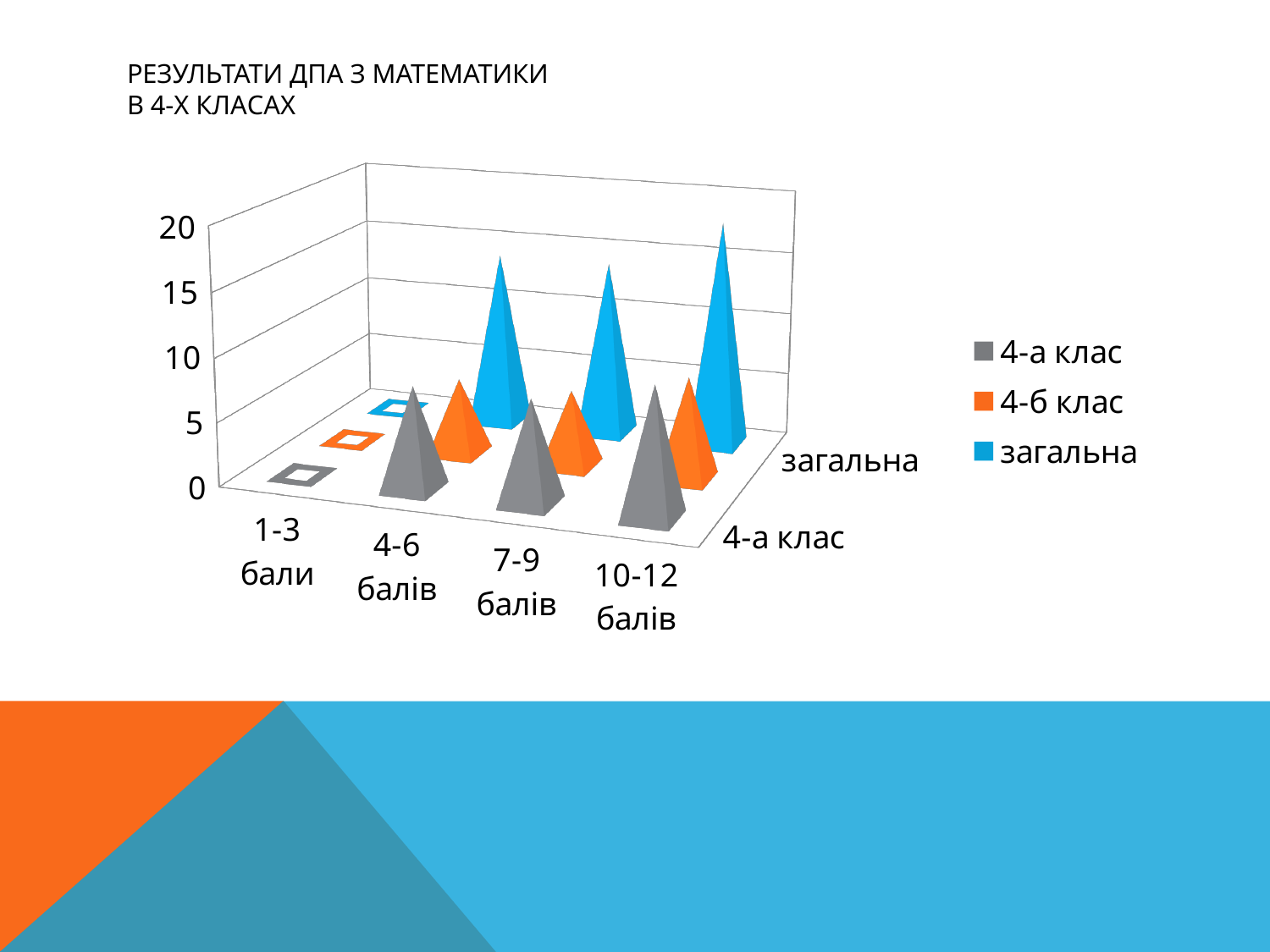
For the series 'загальна', which score category has the highest value? 10-12 балів How many score categories are shown on the x axis? 4 Is the value for '4-б клас' in the category '1-3 бали' greater or less than 5? less For the category '4-6 балів', which is larger: the value for '4-б клас' or for 'загальна'? загальна Is the value for 'загальна' in the category '10-12 балів' greater or less than 10? greater How many series does the legend list? 3 Which colour represents the series 'загальна' in the legend? blue For the category '10-12 балів', which is larger: the value for '4-а клас' or for 'загальна'? загальна For the series 'загальна', which score category has the lowest value? 1-3 бали What is the title of the chart? РЕЗУЛЬТАТИ ДПА З МАТЕМАТИКИ В 4-Х КЛАСАХ What kind of chart is shown on the slide? bar chart Is the value for '4-а клас' in the category '10-12 балів' greater or less than 5? greater